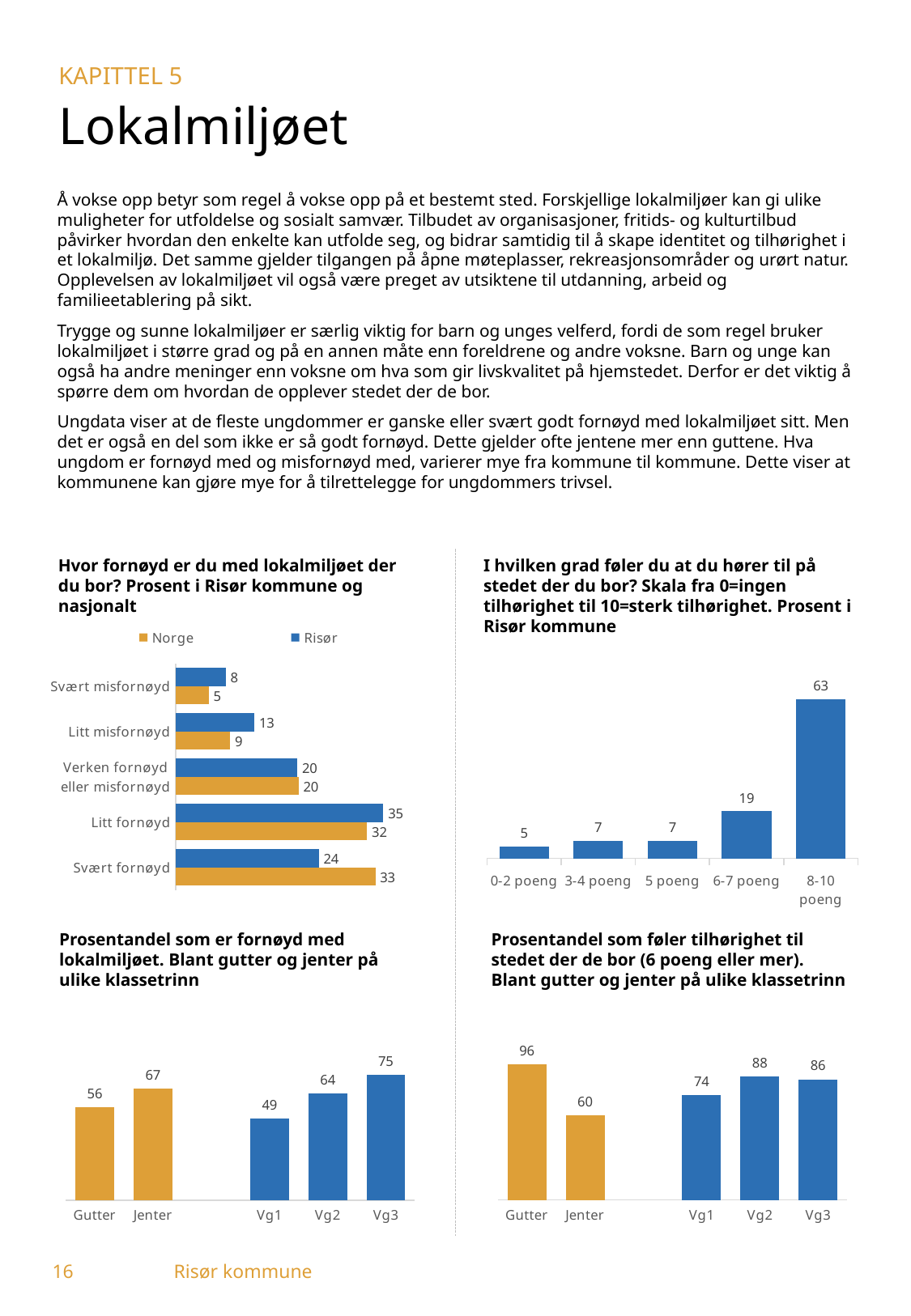
In the top-left chart 'Hvor fornøyd er du med lokalmiljøet der du bor?', what is the Norge value for 'Litt misfornøyd'? 9 In the bottom-left chart 'Prosentandel som er fornøyd med lokalmiljøet', what is the value for Vg1? 49 In the bottom-left chart 'Prosentandel som er fornøyd med lokalmiljøet', do the values rise or fall from Vg1 to Vg3? rise In the top-left chart 'Hvor fornøyd er du med lokalmiljøet der du bor?', how many series does the legend list? 2 In the top-right chart 'I hvilken grad føler du at du hører til på stedet der du bor?', which category has the highest value? 8-10 poeng In the bottom-right chart 'Prosentandel som føler tilhørighet til stedet der de bor', what is the difference between Vg2 and Vg1? 14 In the top-right chart 'I hvilken grad føler du at du hører til på stedet der du bor?', how many categories are shown on the x axis? 5 In the bottom-right chart 'Prosentandel som føler tilhørighet til stedet der de bor', which is larger, Gutter or Jenter? Gutter In the top-right chart 'I hvilken grad føler du at du hører til på stedet der du bor?', what is the value for '6-7 poeng'? 19 In the top-left chart 'Hvor fornøyd er du med lokalmiljøet der du bor?', what is the Risør value for 'Svært fornøyd'? 24 In the top-left chart 'Hvor fornøyd er du med lokalmiljøet der du bor?', what is the difference between the Norge and Risør values for 'Svært fornøyd'? 9 What kind of chart is the top-left chart 'Hvor fornøyd er du med lokalmiljøet der du bor?'? bar chart